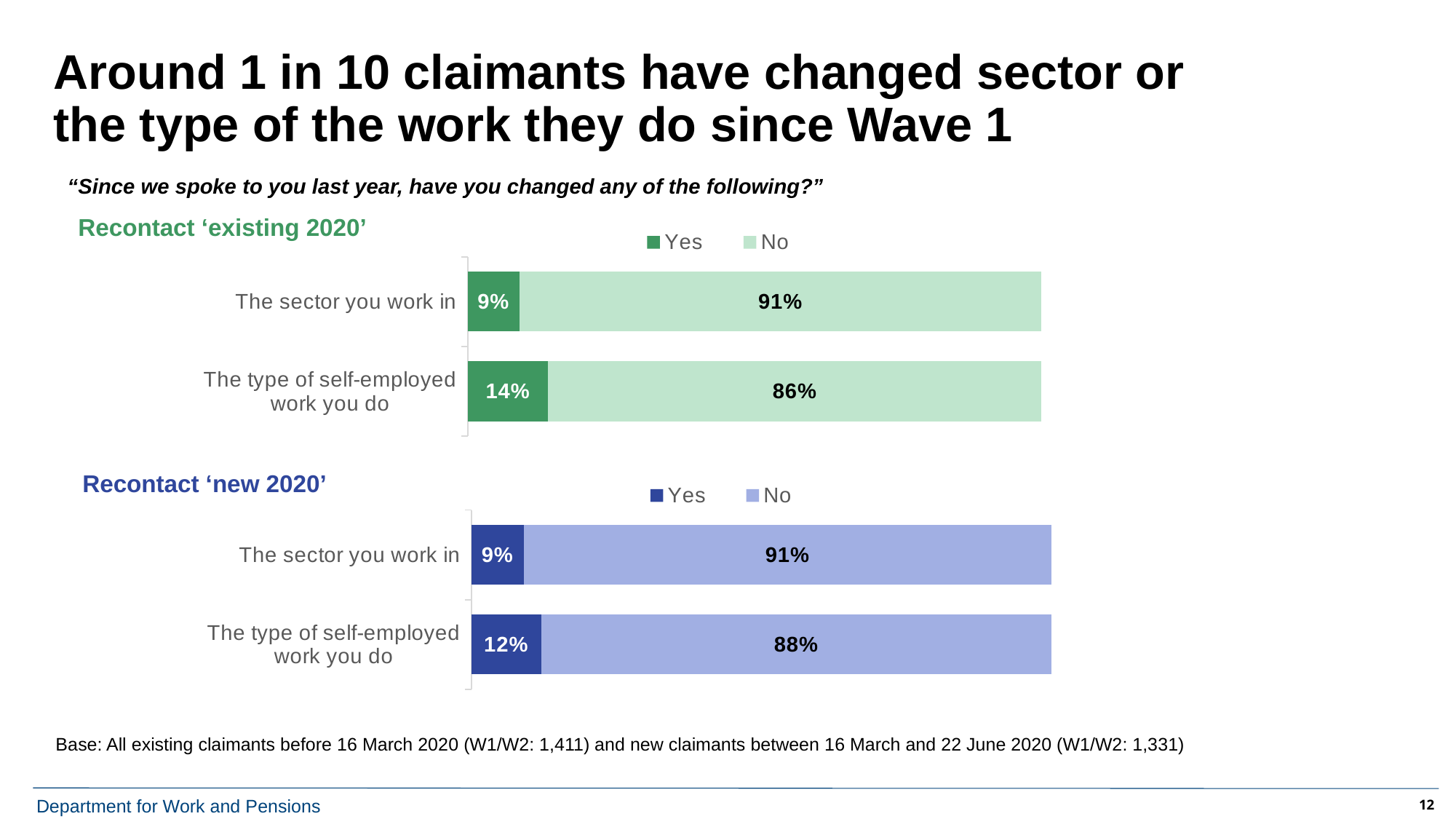
In the Recontact 'new 2020' chart, which category has the lower Yes percentage? The sector you work in In the Recontact 'existing 2020' chart, which category has the higher Yes percentage? The type of self-employed work you do What type of chart is the Recontact 'existing 2020' chart? Stacked bar chart In the Recontact 'existing 2020' chart, what percentage said No to changing the type of self-employed work they do? 86% In the Recontact 'new 2020' chart, what percentage said Yes to changing the type of self-employed work they do? 12% How many categories are shown in the Recontact 'new 2020' chart? 2 In the Recontact 'new 2020' chart, what is the difference between the No percentages for the sector you work in and the type of self-employed work you do? 3% In the Recontact 'existing 2020' chart, what percentage said Yes to changing the sector they work in? 9% In the Recontact 'existing 2020' chart, what is the difference between the Yes percentages for the type of self-employed work and the sector you work in? 5% In the Recontact 'new 2020' chart, what percentage said No to changing the sector they work in? 91% How many series does the legend of the Recontact 'existing 2020' chart list? 2 Is the Yes percentage for the type of self-employed work you do larger in the Recontact 'existing 2020' chart or the Recontact 'new 2020' chart? Recontact 'existing 2020'